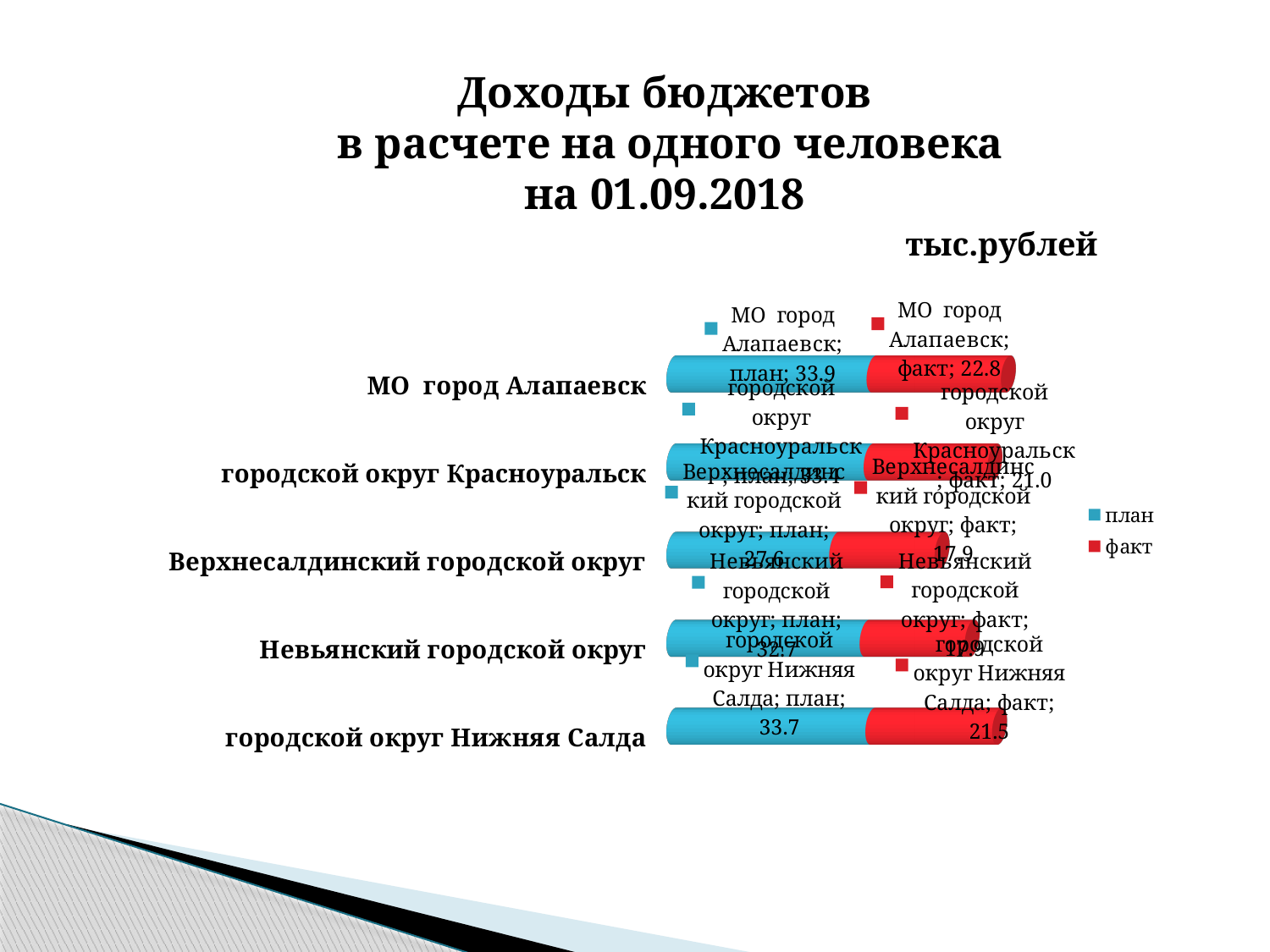
What is the факт value for Верхнесалдинский городской округ? 17.9 How many municipalities (categories) are shown in the chart? 5 What is the факт value for городской округ Нижняя Салда? 21.5 What is the план value for Верхнесалдинский городской округ? 27.6 How many series does the legend list? 2 What is the план value for МО город Алапаевск? 33.9 What is the difference between the план and факт values for МО город Алапаевск? 11.1 What is the факт value for городской округ Красноуральск? 21.0 Which has the larger план value: МО город Алапаевск or Верхнесалдинский городской округ? МО город Алапаевск What type of chart is shown on the slide? bar chart What is the план value for городской округ Нижняя Салда? 33.7 What is the факт value for МО город Алапаевск? 22.8